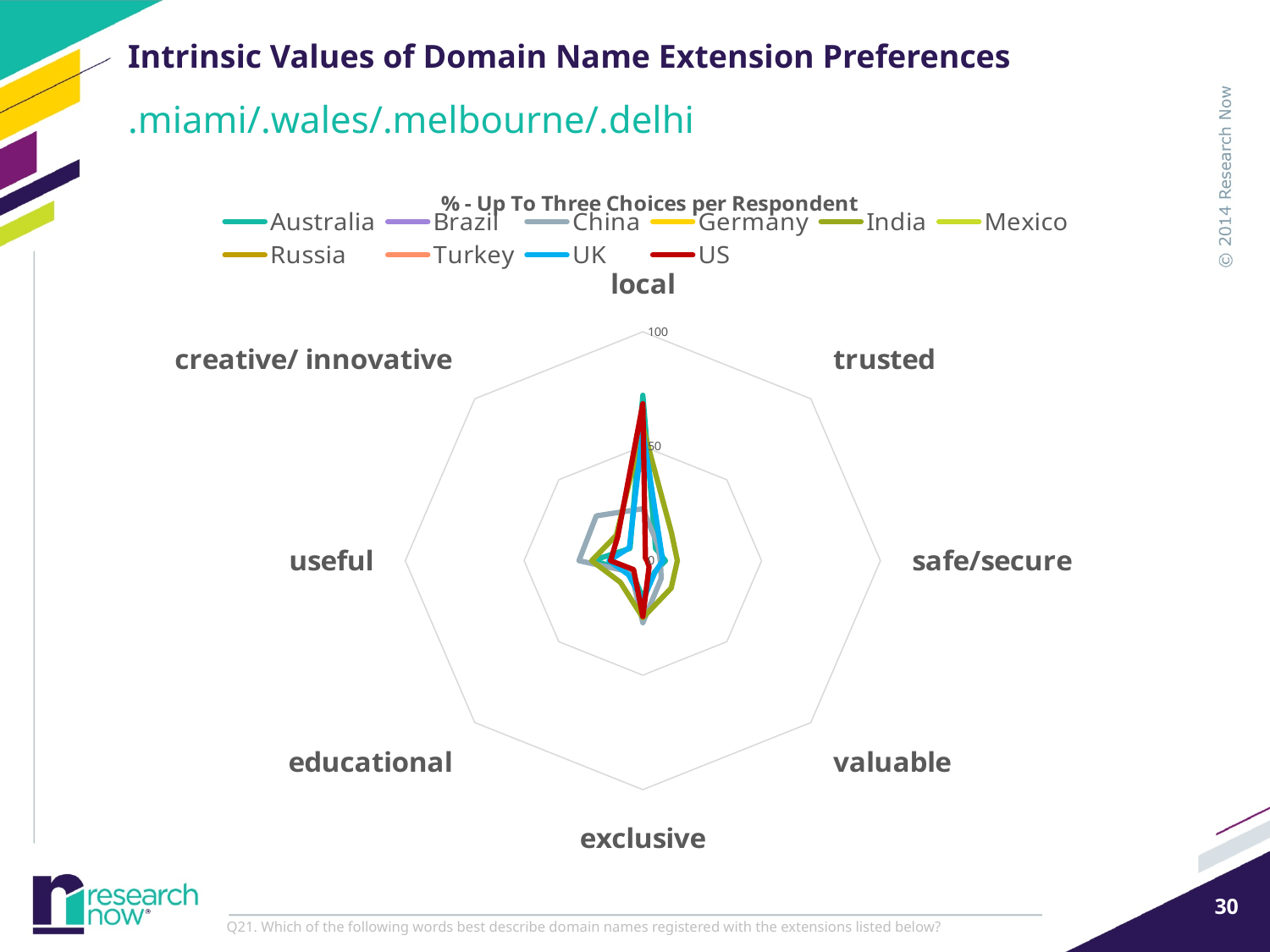
How many series does the legend list? 10 What kind of chart is shown on the slide? radar chart What is the maximum value shown on the radar chart's axis scale? 100 What is the title of the chart? % - Up To Three Choices per Respondent Is the value for exclusive for India greater or less than 50? less Which category has the highest values across the series? local Is the value for local for Australia greater or less than 50? greater Which is larger for US: the value for local or the value for valuable? local Is the value for trusted for US greater or less than 50? less How many categories (axes) does the radar chart have? 8